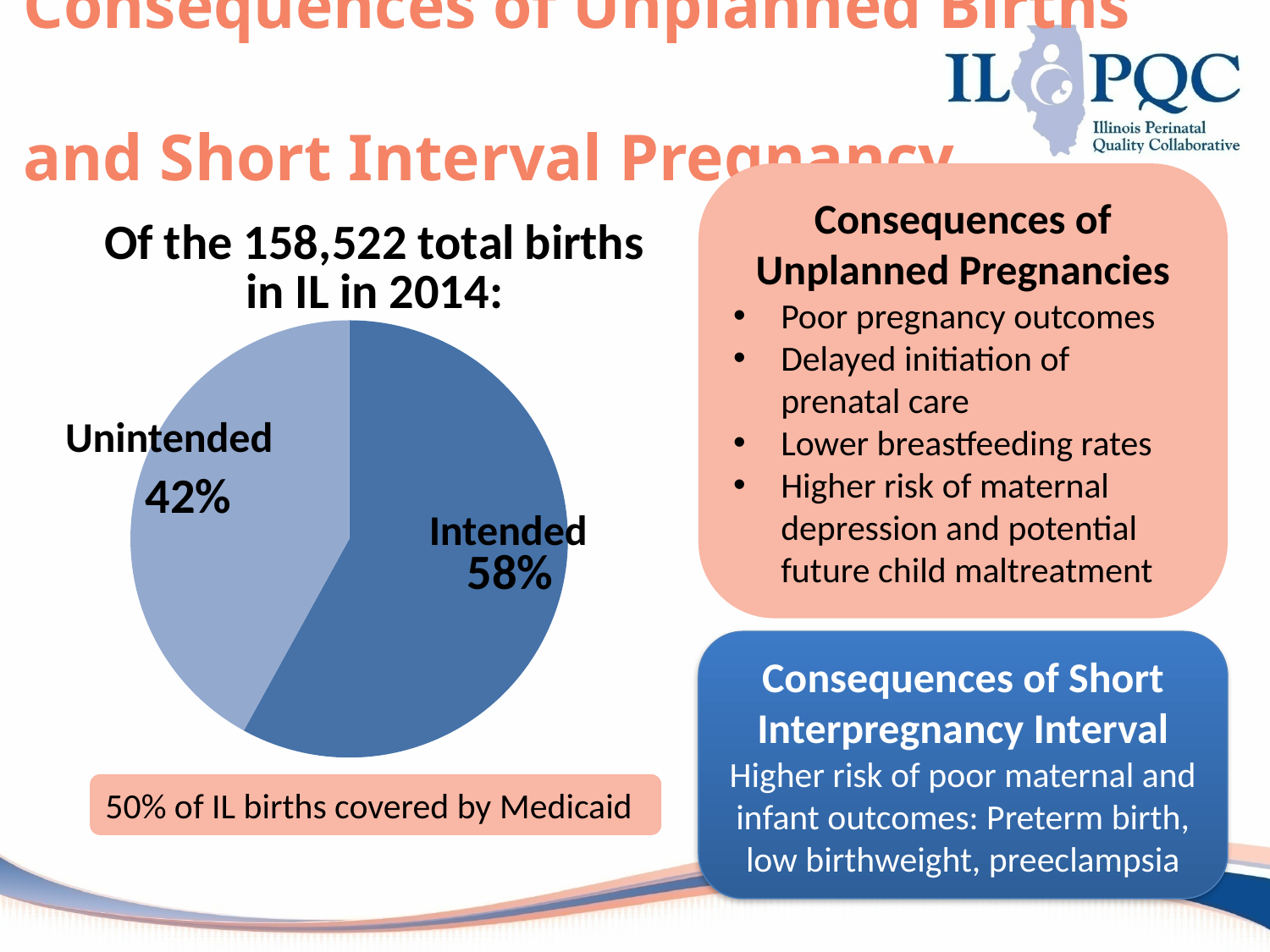
What colour is the Intended slice of the pie chart? dark blue What is the difference in percentage points between the Intended and Unintended slices? 16 How many slices does the pie chart have? 2 What is the title of the pie chart? Of the 158,522 total births in IL in 2014: What percentage of births in the pie chart are Unintended? 42% Is the Unintended share of the pie chart greater or less than 50%? less What kind of chart is shown on the slide? pie chart Which slice of the pie chart is the largest? Intended Which is larger in the pie chart, Intended or Unintended? Intended Which slice of the pie chart is the smallest? Unintended What percentage of births in the pie chart are Intended? 58%